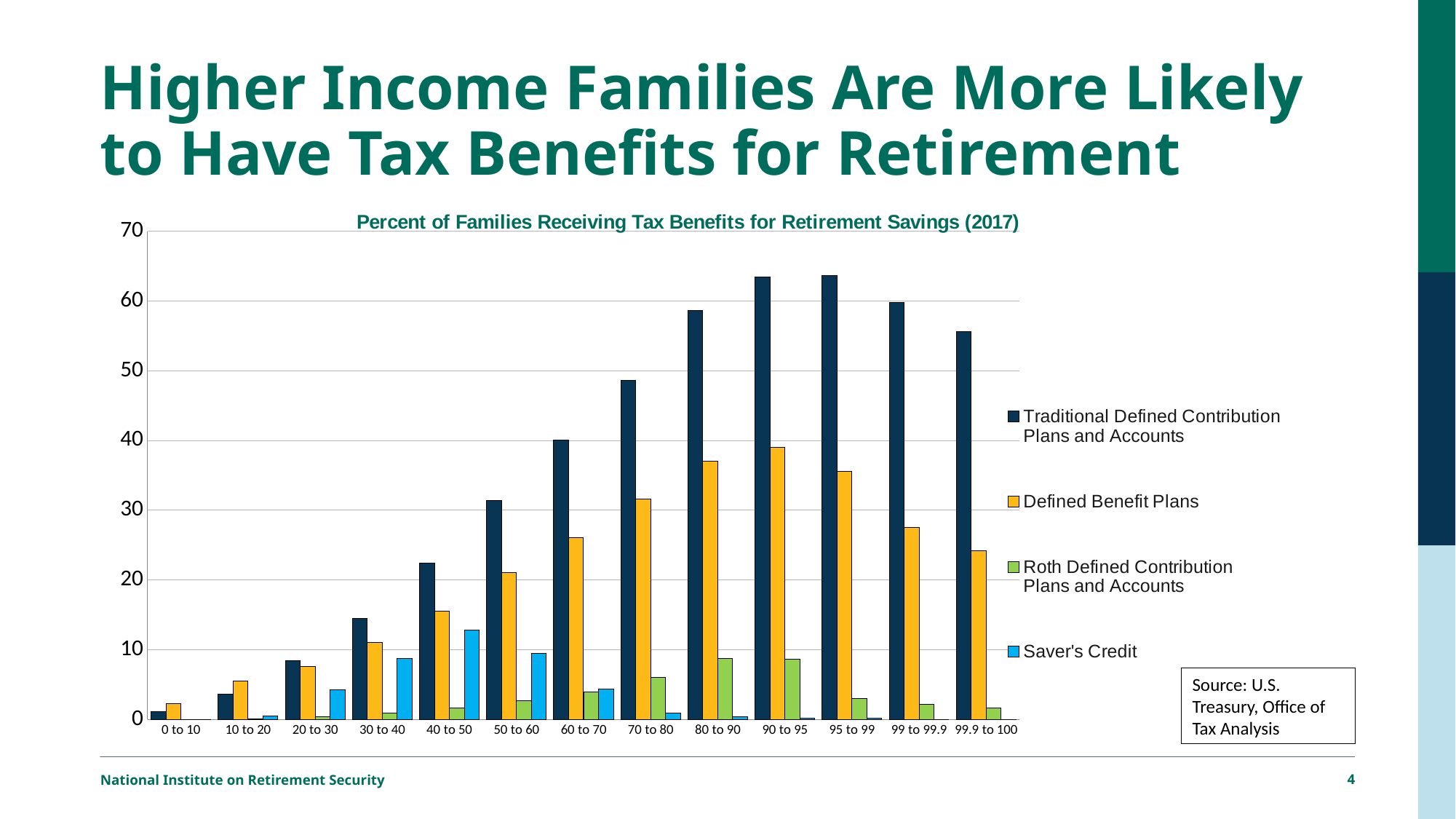
Is the value for Saver's Credit in the 40 to 50 category greater or less than 10? greater Which income category has the lowest value for Traditional Defined Contribution Plans and Accounts? 0 to 10 Is the value for Defined Benefit Plans in the 60 to 70 category greater or less than 20? greater Is the value for Traditional Defined Contribution Plans and Accounts in the 99.9 to 100 category greater or less than 50? greater Do the Saver's Credit values rise or fall from the 40 to 50 category to the 99.9 to 100 category? fall How many series does the legend list? 4 What is the title of the chart? Percent of Families Receiving Tax Benefits for Retirement Savings (2017) What kind of chart is shown on the slide? bar chart How many income categories are shown along the x axis? 13 Which income category has the highest value for Saver's Credit? 40 to 50 In the 50 to 60 category, which is larger: Traditional Defined Contribution Plans and Accounts or Defined Benefit Plans? Traditional Defined Contribution Plans and Accounts